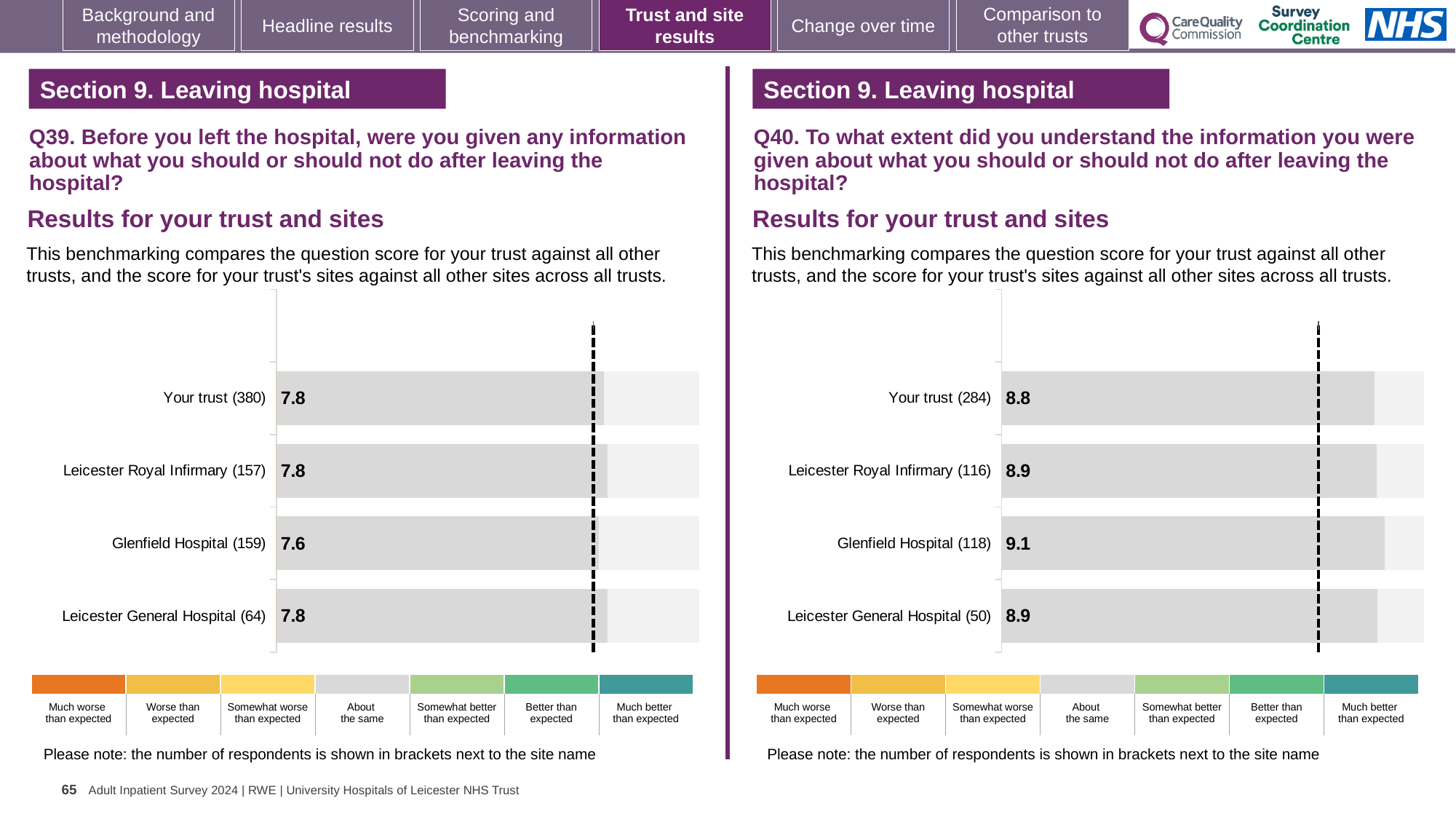
How many benchmark categories are shown in the colour key below the Q40 chart on the right? 7 How many bars are plotted in the Q39 chart on the left? 4 In the Q39 chart on the left, what is the score for Glenfield Hospital? 7.6 In the Q39 chart on the left, what is the score for Your trust? 7.8 In the Q40 chart on the right, which site has the highest score? Glenfield Hospital What kind of chart is used in the Q40 chart on the right? Bar chart In the Q39 chart on the left, how many respondents are shown in brackets for Leicester General Hospital? 64 In the Q39 chart on the left, which has the higher score: Leicester Royal Infirmary or Glenfield Hospital? Leicester Royal Infirmary In the Q40 chart on the right, what is the difference between the Glenfield Hospital score and the Your trust score? 0.3 In the Q40 chart on the right, what is the score for Leicester General Hospital? 8.9 In the Q39 chart on the left, which site has the lowest score? Glenfield Hospital In the Q40 chart on the right, how many respondents are shown in brackets for Your trust? 284